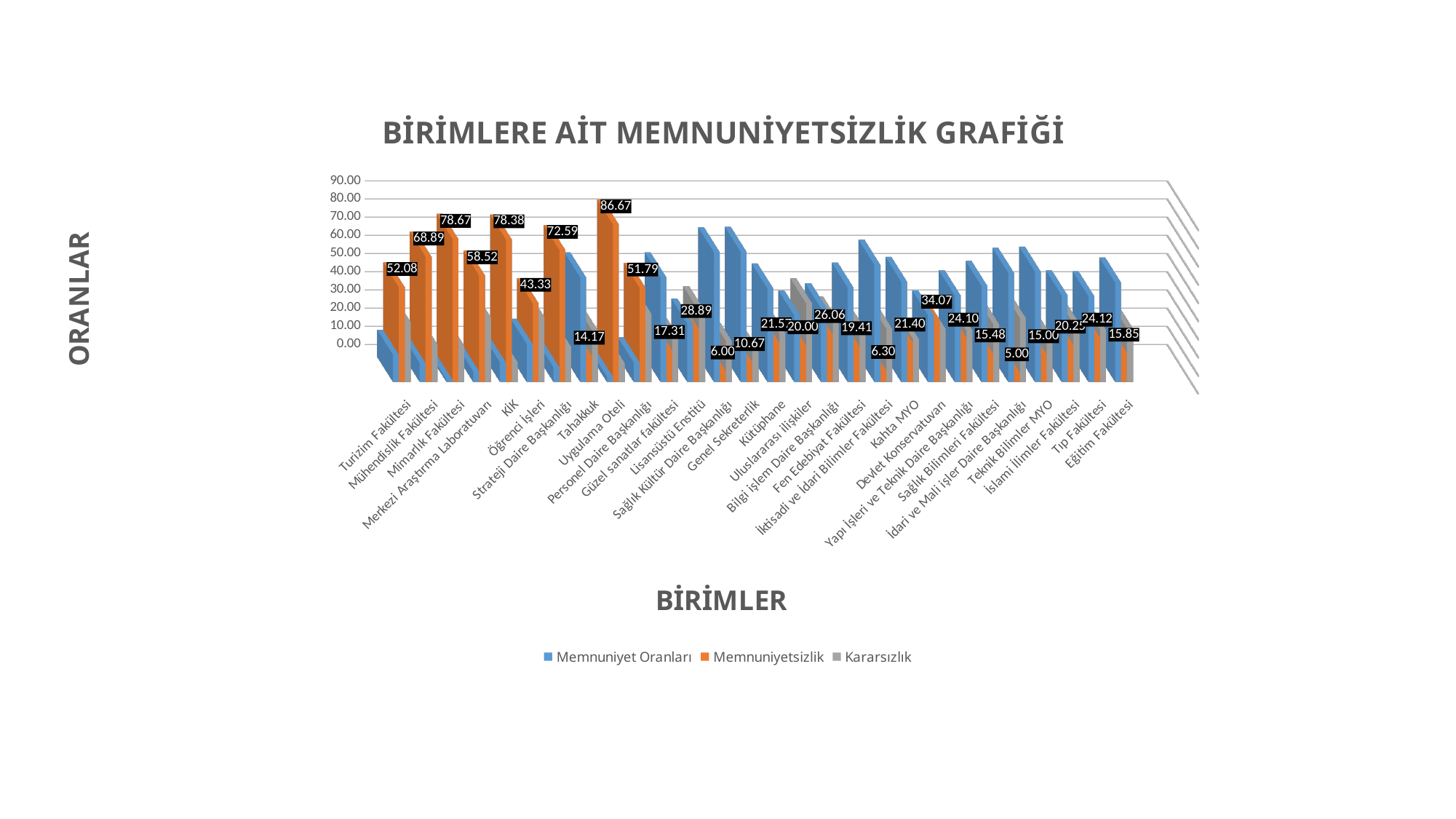
What is the Memnuniyetsizlik value for Tahakkuk? 14.17 What is the difference between the Memnuniyetsizlik values for Mühendislik Fakültesi and Turizim Fakültesi? 16.81 Is the Memnuniyet Oranları value for Lisansüstü Enstitü greater or less than 50.00? less What kind of chart is shown on the slide? Bar chart Which category has the highest Memnuniyetsizlik value? Uygulama Oteli Which category has the lowest Memnuniyetsizlik value? İdari ve Mali İşler Daire Başkanlığı How many categories are shown on the x axis? 28 What is the title of the chart? BİRİMLERE AİT MEMNUNİYETSİZLİK GRAFİĞİ What is the Memnuniyetsizlik value for Mimarlık Fakültesi? 78.67 How many series does the legend list? 3 Which has a larger Memnuniyetsizlik value, KİK or Strateji Daire Başkanlığı? KİK What is the Memnuniyetsizlik value for Uygulama Oteli? 86.67